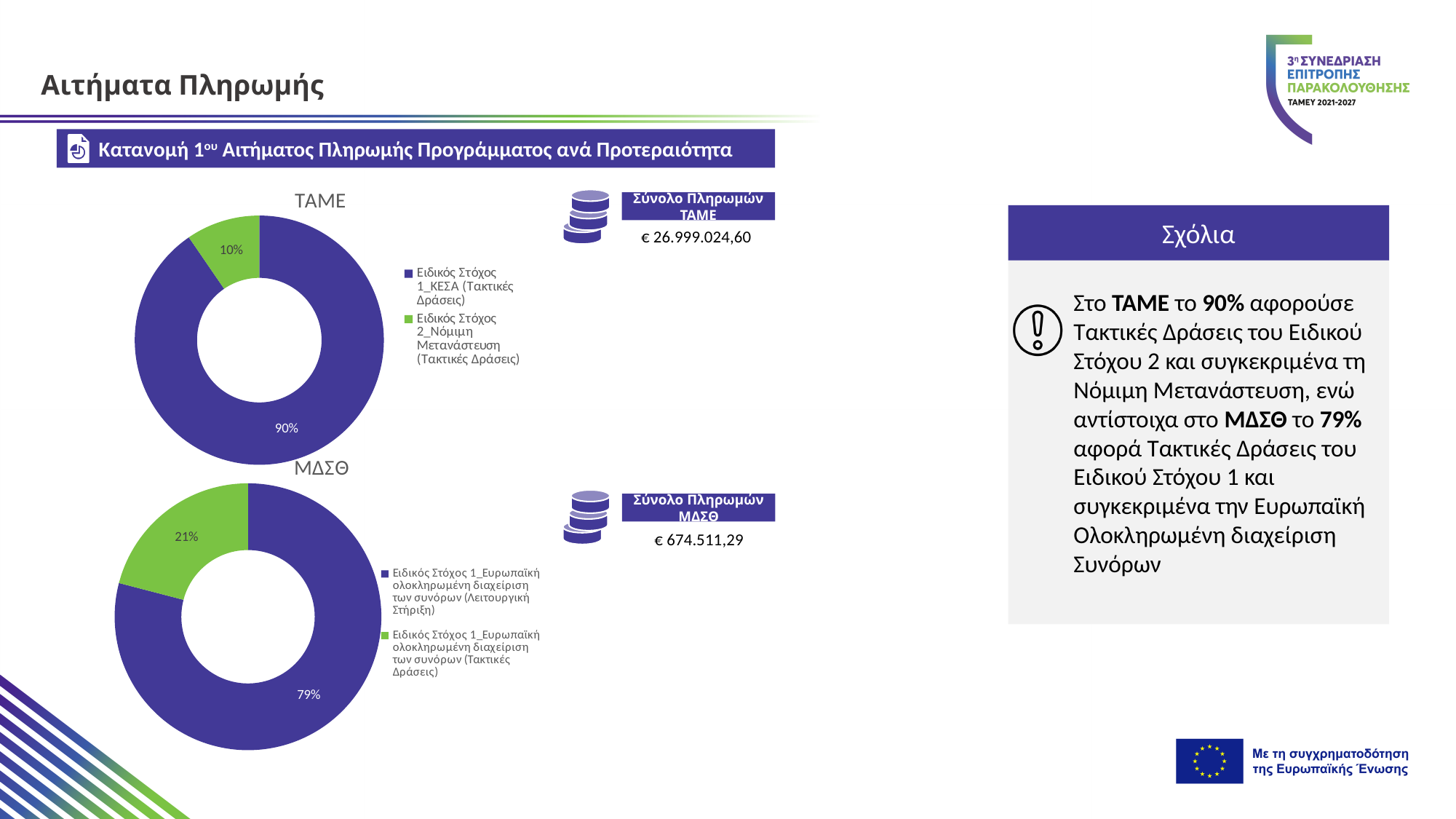
In the ΜΔΣΘ chart, what percentage is shown on the purple slice? 79% In the ΤΑΜΕ chart, what percentage is shown on the smallest slice? 10% In the ΜΔΣΘ chart, what is the difference in percentage points between the two slices? 58 percentage points What kind of chart is used for the ΤΑΜΕ and ΜΔΣΘ data on the slide? Doughnut (pie) chart In the ΤΑΜΕ chart, what percentage is shown on the largest slice? 90% In the ΤΑΜΕ chart, what is the difference in percentage points between the two slices? 80 percentage points How many slices does the ΤΑΜΕ chart have? 2 Which chart has the larger green slice, ΤΑΜΕ or ΜΔΣΘ? ΜΔΣΘ What is the title of the chart section shown on the slide? Κατανομή 1ου Αιτήματος Πληρωμής Προγράμματος ανά Προτεραιότητα What colour is the largest slice in the ΜΔΣΘ chart? Purple In the ΜΔΣΘ chart, what percentage is shown on the green slice? 21% How many entries does the legend of the ΜΔΣΘ chart list? 2